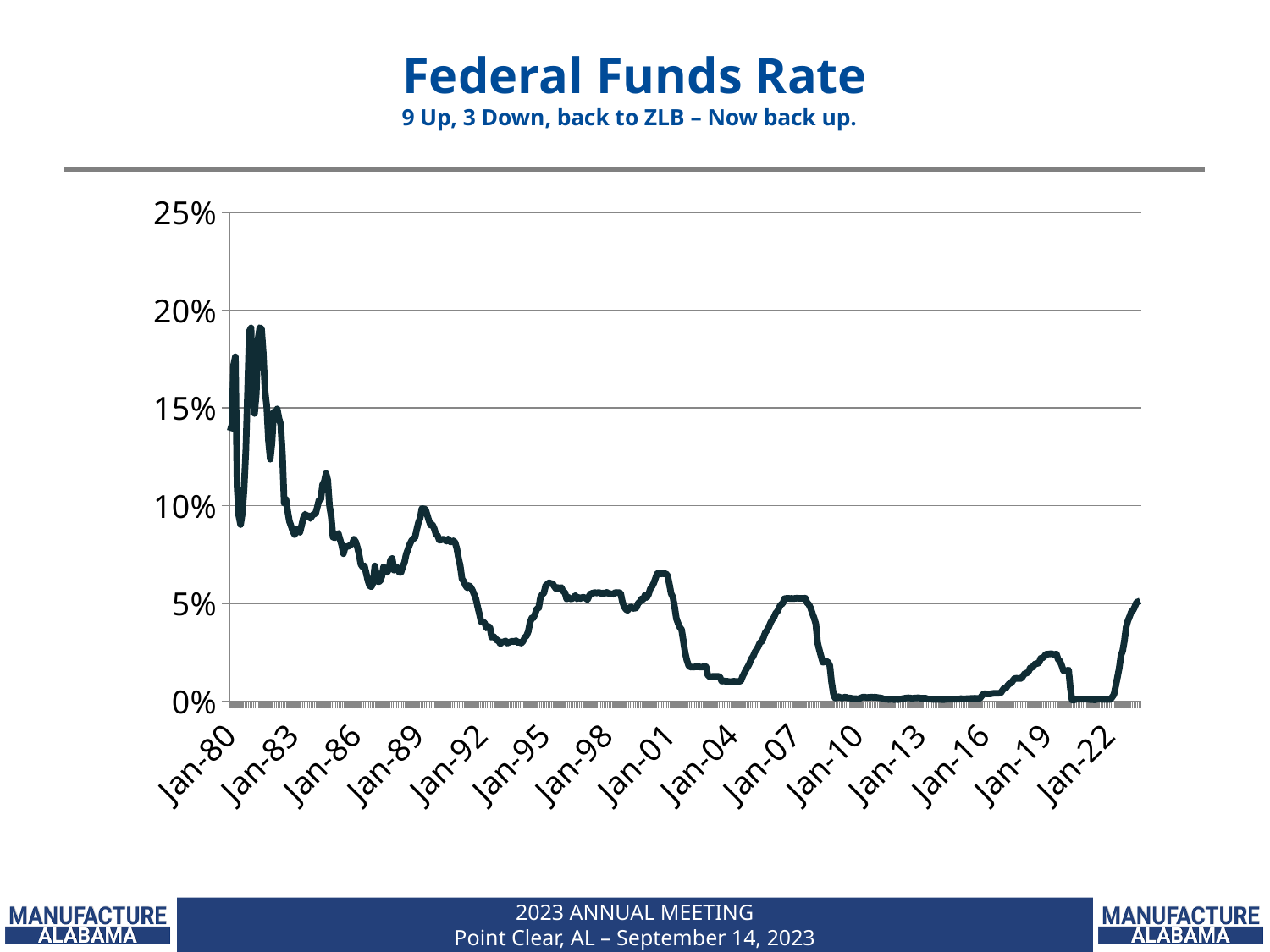
Is the value for Jan-86 greater or less than 5%? greater Is the value for Jan-04 greater or less than 5%? less What is the subtitle printed under the chart title? 9 Up, 3 Down, back to ZLB – Now back up. Overall, does the Federal Funds Rate rise or fall from Jan-80 to Jan-22? fall What is the title of the chart? Federal Funds Rate How many date labels are shown on the x axis? 15 Is the value for Jan-89 greater or less than 5%? greater What kind of chart is shown on the slide? line chart